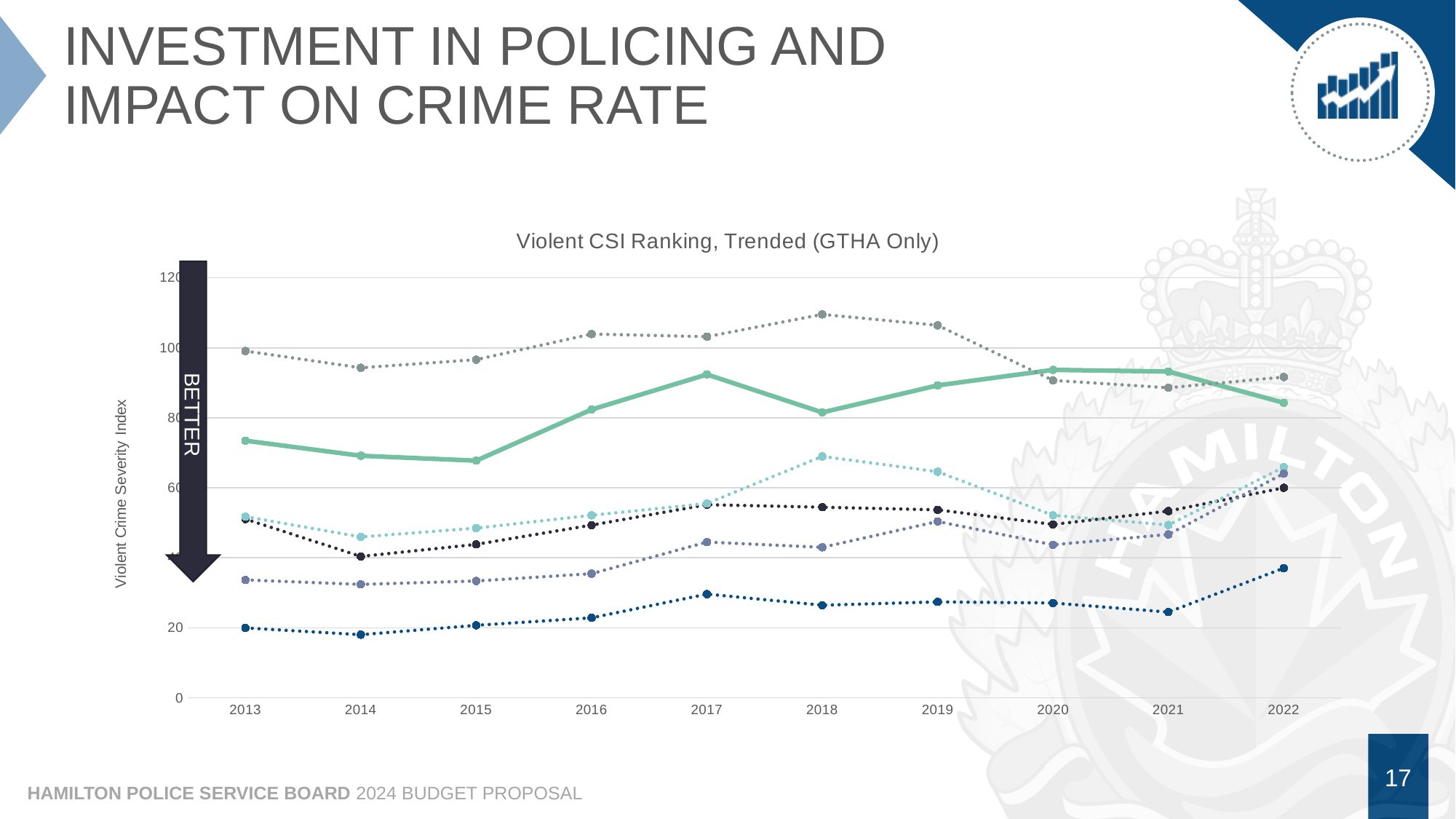
Is the value of the lowest dark blue dotted line in 2022 greater or less than 20? greater Does the solid green line rise or fall overall from 2013 to 2022? rise How many lines are plotted on the chart? 6 What is the label on the vertical axis of the chart? Violent Crime Severity Index For the solid green line, is the value in 2017 higher or lower than in 2018? higher Is the value of the solid green line in 2015 greater or less than 80? less Is the value of the topmost grey dotted line in 2022 greater or less than 100? less What kind of chart is shown on the slide? line chart How many years are shown along the x axis of the chart? 10 What is the title of the chart? Violent CSI Ranking, Trended (GTHA Only)